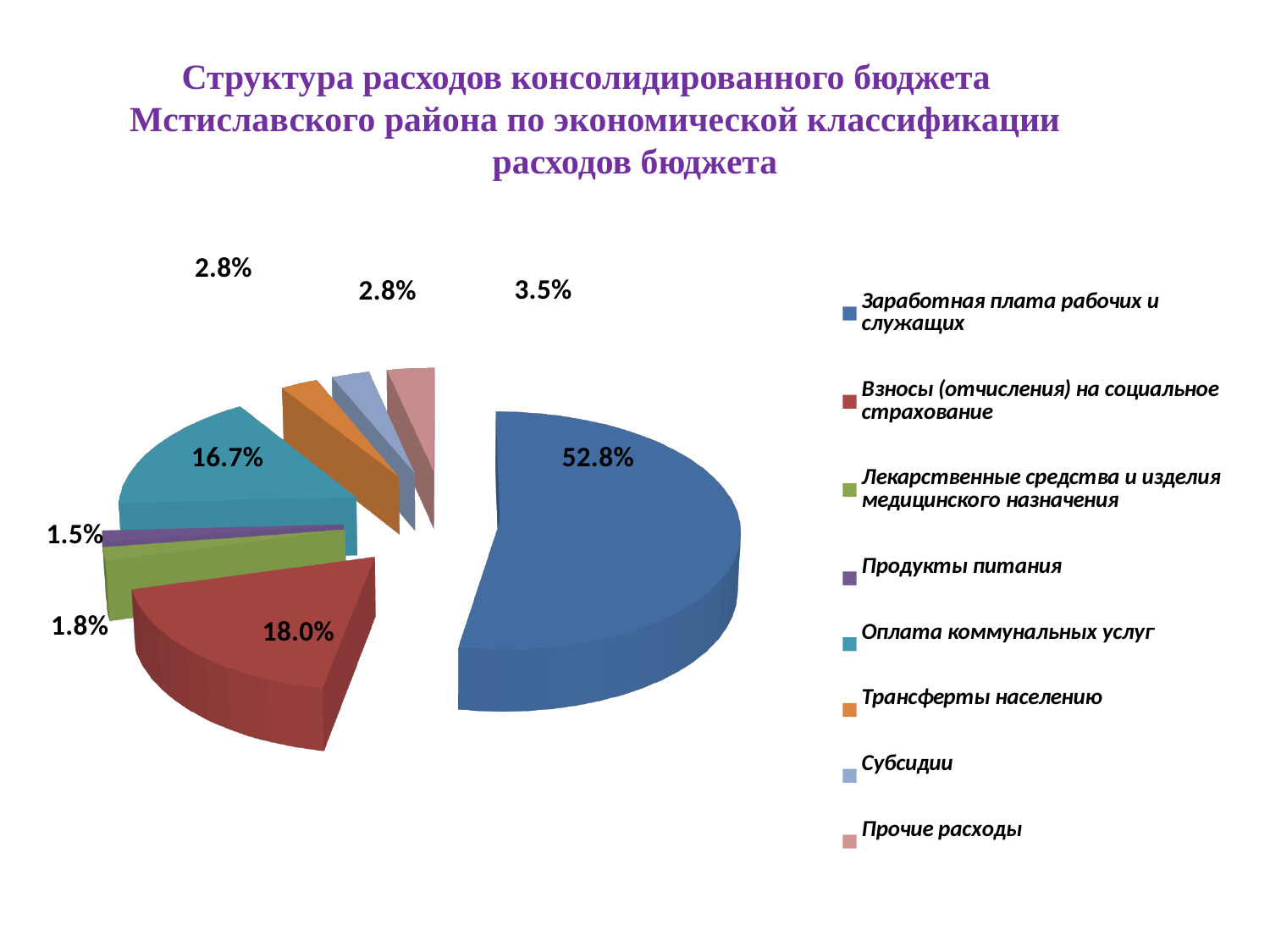
What share of expenditures is for Продукты питания? 1.5% Which category has the largest share of expenditures? Заработная плата рабочих и служащих How many categories does the legend list? 8 Which is larger: the share for Взносы (отчисления) на социальное страхование or the share for Оплата коммунальных услуг? Взносы (отчисления) на социальное страхование What share of expenditures is for Заработная плата рабочих и служащих? 52.8% What share of expenditures is for Оплата коммунальных услуг? 16.7% What share of expenditures is for Прочие расходы? 3.5% What share of expenditures is for Лекарственные средства и изделия медицинского назначения? 1.8% What type of chart is shown on the slide? pie chart What is the difference in percentage points between Взносы (отчисления) на социальное страхование and Оплата коммунальных услуг? 1.3 What share of expenditures is for Взносы (отчисления) на социальное страхование? 18.0% Which category has the smallest share of expenditures? Продукты питания